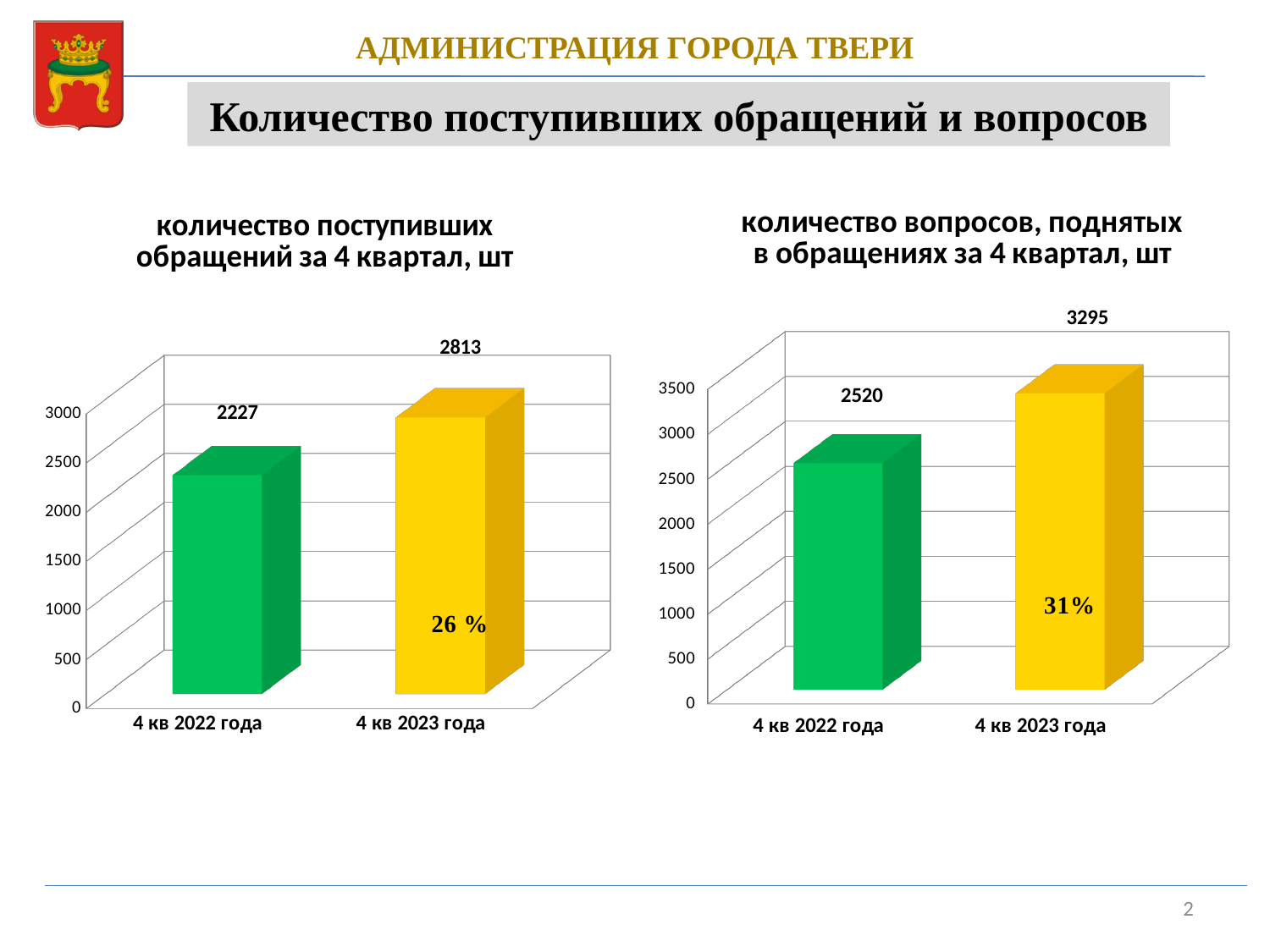
How many categories are shown on the x axis of the right chart? 2 In the right chart, which period has the lower value? 4 кв 2022 года What kind of chart is the left chart? bar chart In the right chart 'количество вопросов, поднятых в обращениях за 4 квартал, шт', what is the value for 4 кв 2023 года? 3295 In the right chart, is the value for 4 кв 2023 года greater or less than 3000? greater In the right chart 'количество вопросов, поднятых в обращениях за 4 квартал, шт', what is the value for 4 кв 2022 года? 2520 In the left chart 'количество поступивших обращений за 4 квартал, шт', what is the value for 4 кв 2023 года? 2813 In the right chart, what is the difference between the values for 4 кв 2023 года and 4 кв 2022 года? 775 In the left chart 'количество поступивших обращений за 4 квартал, шт', what is the value for 4 кв 2022 года? 2227 In the left chart, what is the difference between the values for 4 кв 2023 года and 4 кв 2022 года? 586 In the left chart, which period has the higher value? 4 кв 2023 года What percentage label is printed on the 4 кв 2023 года bar in the right chart? 31%